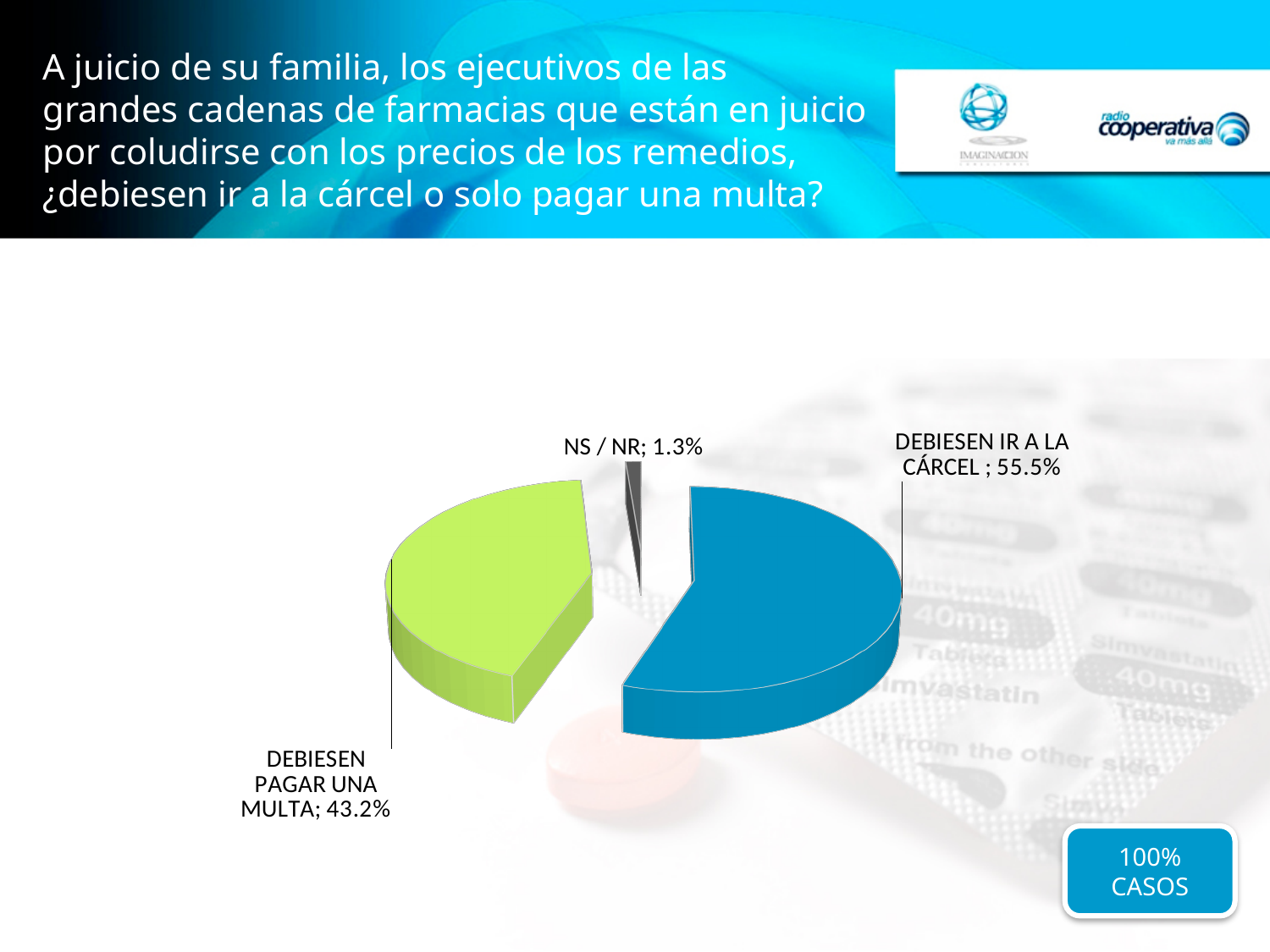
How many slices does the pie chart have? 3 What is the value shown for NS / NR? 1.3% What colour is the slice for DEBIESEN IR A LA CÁRCEL? Blue What percentage of respondents said the executives should pay a fine (DEBIESEN PAGAR UNA MULTA)? 43.2% What kind of chart is shown on the slide? Pie chart What is the difference in percentage points between DEBIESEN IR A LA CÁRCEL and DEBIESEN PAGAR UNA MULTA? 12.3 What colour is the slice for DEBIESEN PAGAR UNA MULTA? Green Which category has the largest share of the pie? DEBIESEN IR A LA CÁRCEL What is the combined share of DEBIESEN IR A LA CÁRCEL and NS / NR? 56.8% What percentage of respondents said the executives should go to jail (DEBIESEN IR A LA CÁRCEL)? 55.5% Which is larger, the share for DEBIESEN PAGAR UNA MULTA or the share for NS / NR? DEBIESEN PAGAR UNA MULTA Which category has the smallest share of the pie? NS / NR